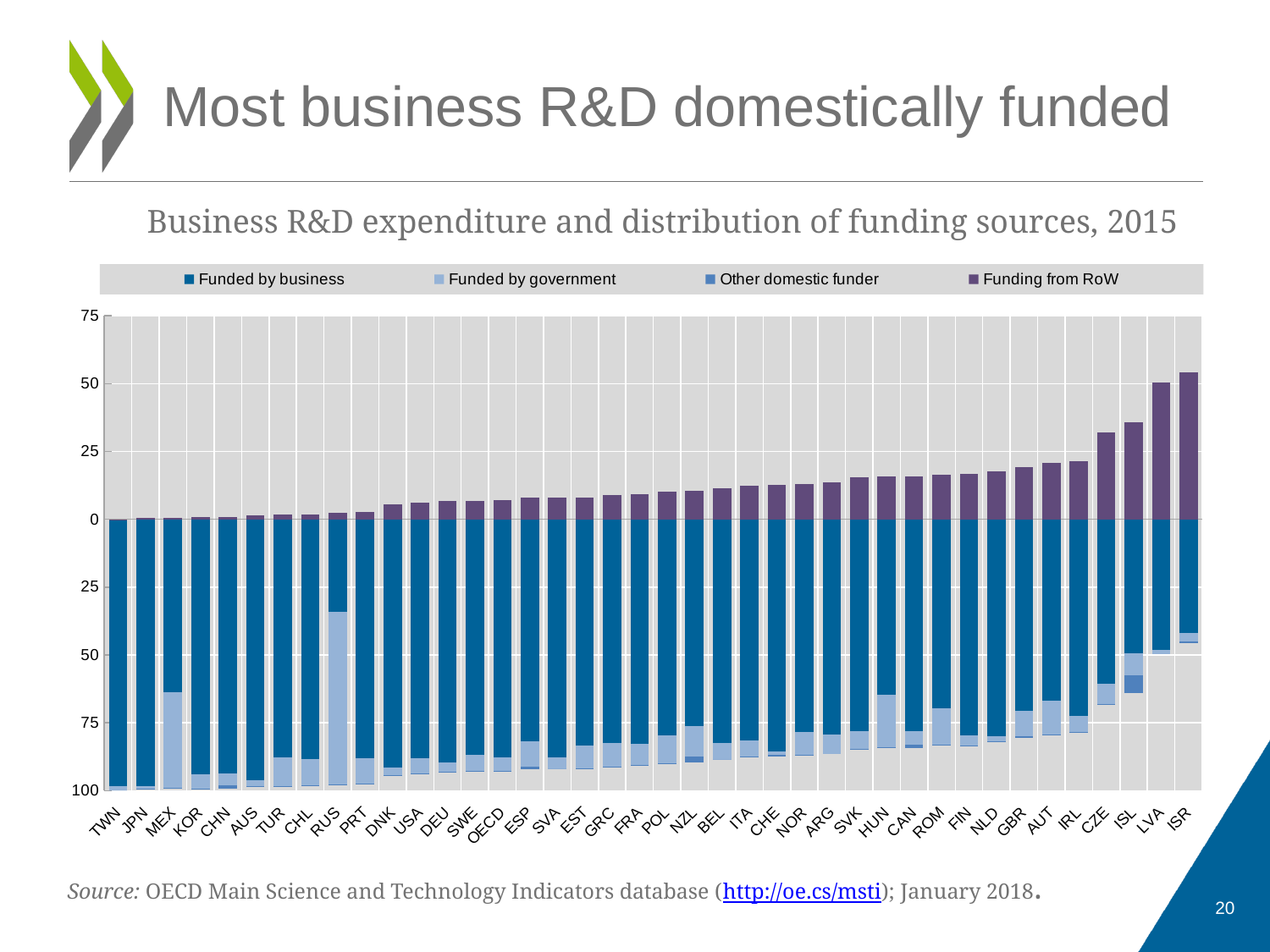
Which category has the largest 'Funded by government' share? RUS Which has a larger 'Funding from RoW' share, ISR or CZE? ISR Which category has the largest 'Funding from RoW' share? ISR What kind of chart is shown on the slide? Stacked bar chart Does the 'Funding from RoW' share rise or fall moving from left to right along the x axis? Rise Is the 'Funding from RoW' value for CZE greater or less than 25? greater How many series does the legend list? 4 Is the 'Funding from RoW' value for IRL greater or less than 25? less Is the 'Funded by government' value for RUS greater or less than 50? greater What is the title of the chart? Business R&D expenditure and distribution of funding sources, 2015 How many countries/categories are shown along the x axis? 40